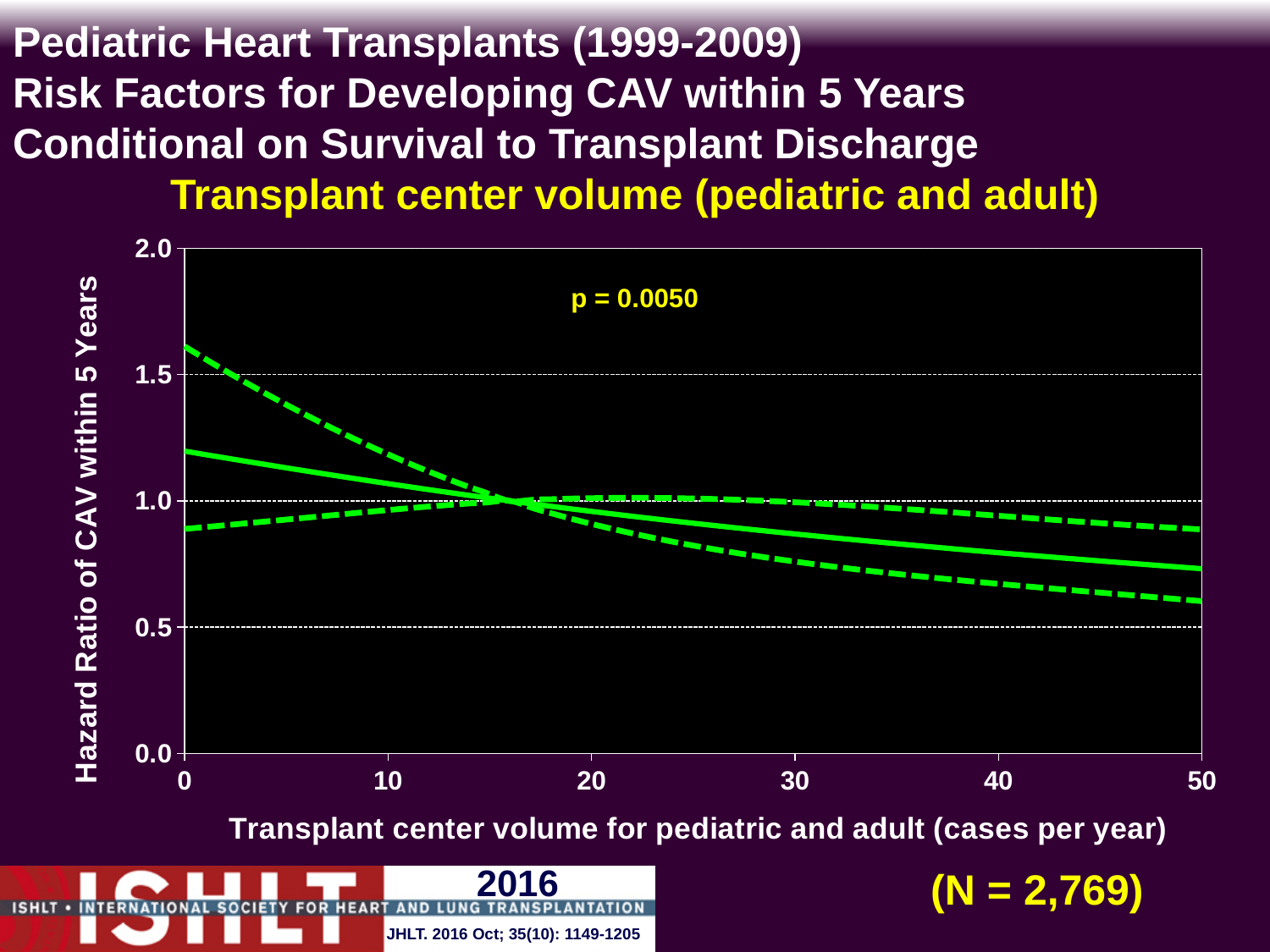
Does the solid hazard ratio line rise or fall as transplant center volume increases from 0 to 50 cases per year? fall Is the solid line's hazard ratio higher at a center volume of 0 or at a center volume of 50 cases per year? 0 What is the maximum value shown on the x axis of the chart? 50 What p-value is printed on the chart? p = 0.0050 Is the hazard ratio on the solid line at a transplant center volume of 0 cases per year greater or less than 1.0? greater What is the sample size (N) shown on the slide? 2,769 What is the maximum value shown on the y axis of the chart? 2.0 What kind of chart is shown on the slide? line chart How many lines are plotted on the chart? 3 Is the hazard ratio on the solid line at a transplant center volume of 50 cases per year greater or less than 1.0? less Is the upper dashed line at a transplant center volume of 0 cases per year greater or less than 1.5? greater